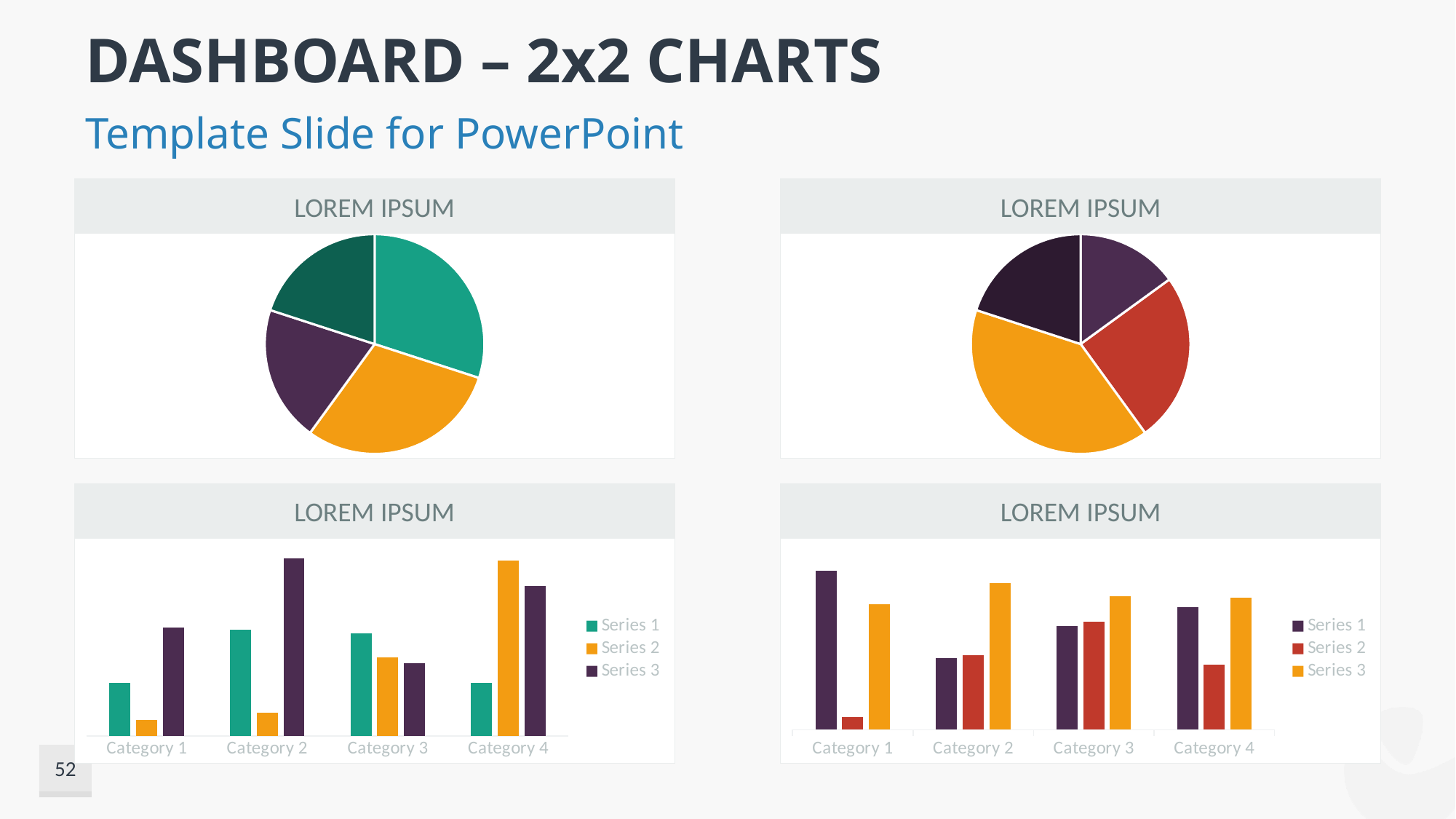
In the bottom-left bar chart, how many series does the legend list? 3 In the bottom-left bar chart, which series has the lowest bar in Category 1? Series 2 In the top-left pie chart, how many slices are there? 4 In the top-right pie chart, which colour slice is the largest? Orange In the bottom-left bar chart, which series has the highest bar in Category 2? Series 3 In the bottom-left bar chart, how many categories are shown on the x axis? 4 What kind of chart is in the bottom-right panel of the slide? Bar chart What kind of chart is in the top-left panel of the slide? Pie chart In the bottom-right bar chart, in Category 3, is the bar for Series 3 larger or smaller than the bar for Series 1? Larger In the bottom-right bar chart, which series has the lowest bar in Category 1? Series 2 In the top-right pie chart, how many slices are there? 4 In the bottom-right bar chart, how many series does the legend list? 3